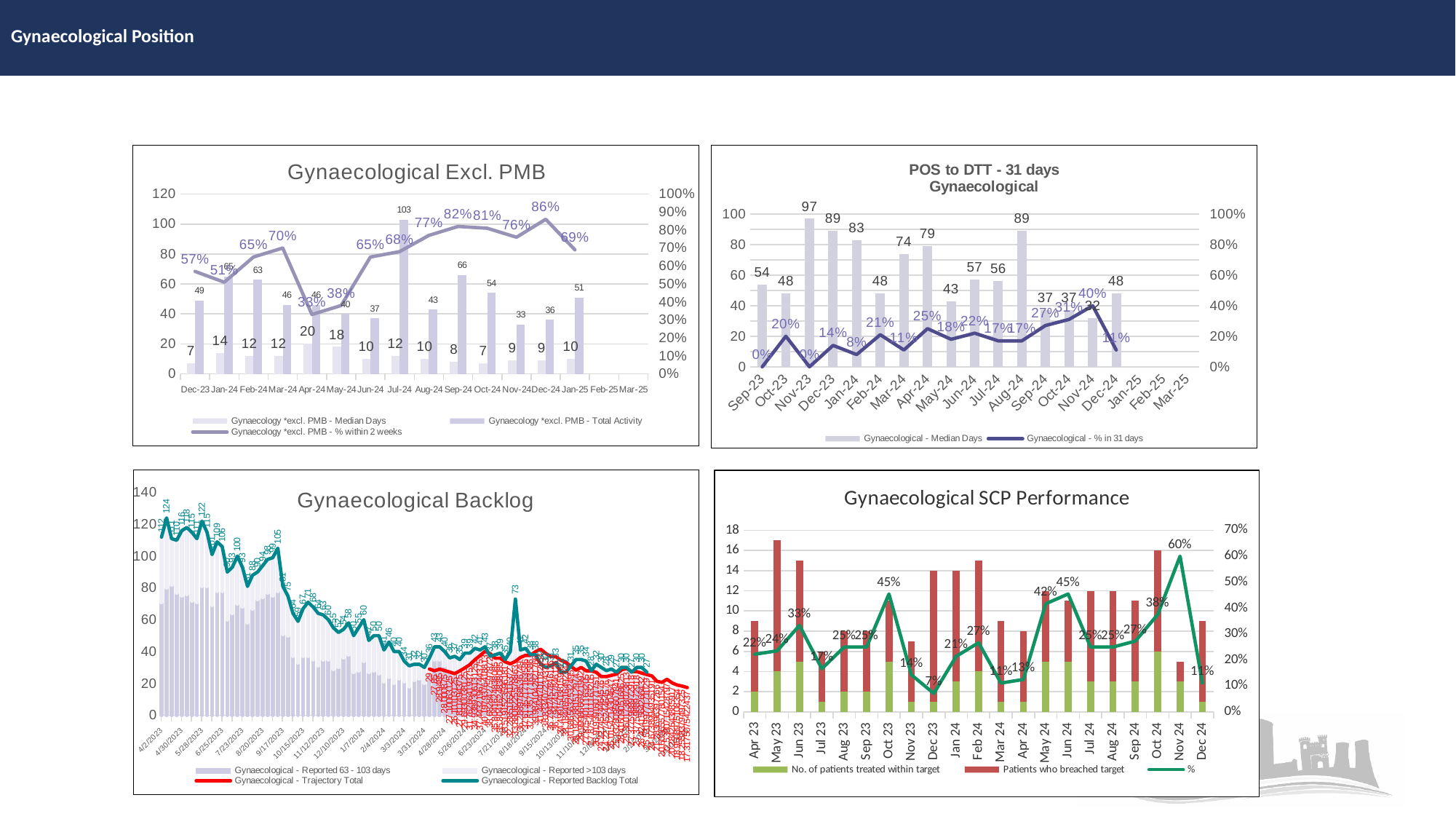
In the 'Gynaecological Excl. PMB' chart, what is the total activity value for Jul-24? 103 In the 'Gynaecological Backlog' chart, what is the highest reported backlog total value labelled at the start of the series? 124 In the 'POS to DTT - 31 days Gynaecological' chart, what is the difference in median days between Nov-23 and Dec-24? 49 In the 'Gynaecological Excl. PMB' chart, which month has the highest total activity? Jul-24 In the 'Gynaecological Excl. PMB' chart, what is the % within 2 weeks for Dec-24? 86% In the 'POS to DTT - 31 days Gynaecological' chart, what is the median days value for Nov-23? 97 In the 'Gynaecological SCP Performance' chart, which month has the lowest percentage? Dec 23 In the 'Gynaecological Excl. PMB' chart, what is the median days value for Apr-24? 20 In the 'Gynaecological SCP Performance' chart, what is the percentage for Nov 24? 60% In the 'POS to DTT - 31 days Gynaecological' chart, which month has the highest % in 31 days? Nov-24 In the 'POS to DTT - 31 days Gynaecological' chart, is the median days value for Aug-24 larger than for Sep-24? Yes How many series does the legend of the 'Gynaecological SCP Performance' chart list? 3